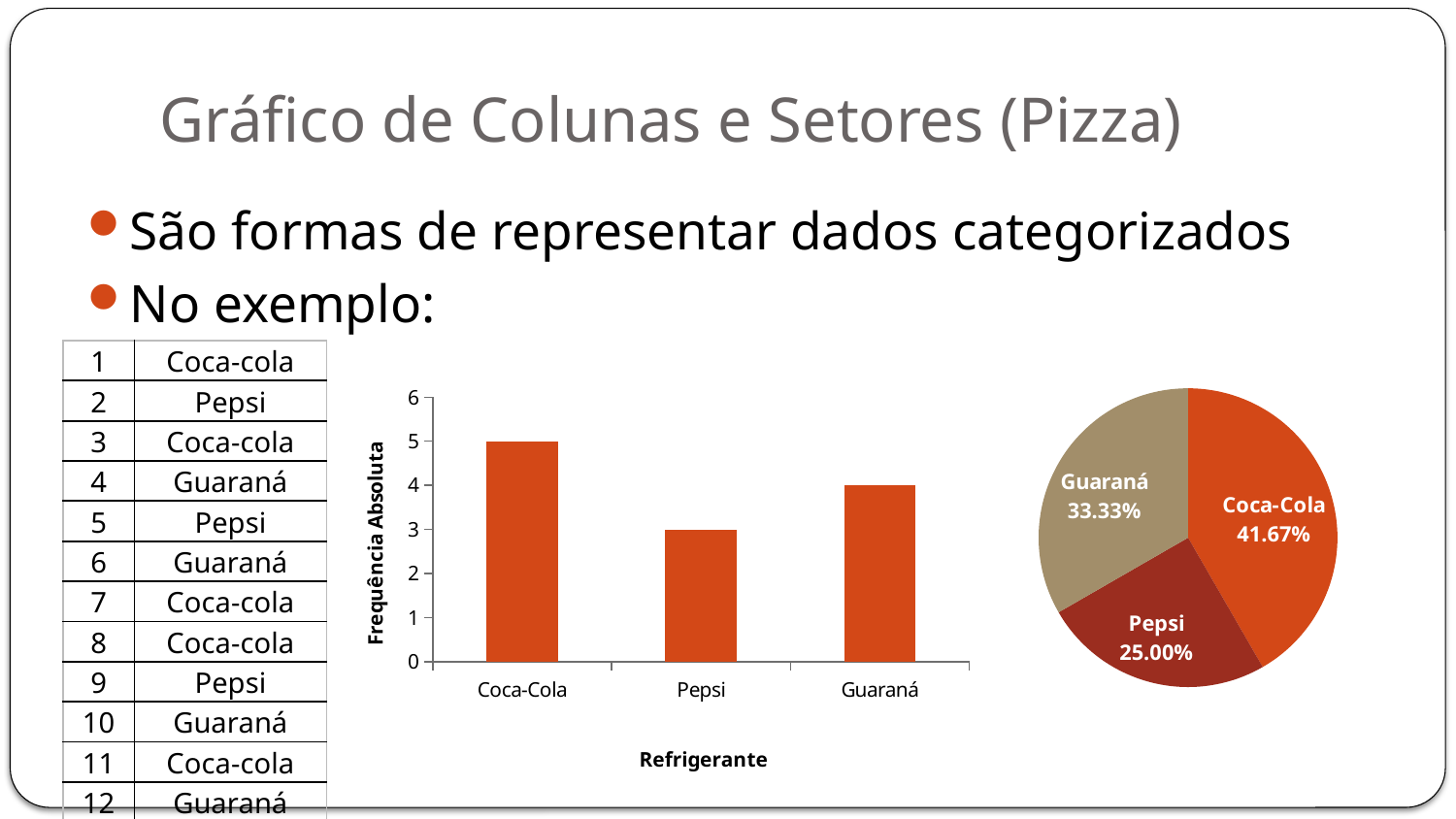
In the bar chart, which refrigerante has the highest Frequência Absoluta? Coca-Cola In the bar chart, what is the Frequência Absoluta for Coca-Cola? 5 In the bar chart, what is the Frequência Absoluta for Pepsi? 3 In the pie chart, what share does Pepsi have? 25.00% In the bar chart, which is larger, the value for Guaraná or the value for Pepsi? Guaraná What kind of chart is the chart on the left with the axis title Refrigerante? Bar chart How many categories are shown on the x axis of the bar chart? 3 In the pie chart, what share does Coca-Cola have? 41.67% In the bar chart, what is the difference between the Frequência Absoluta of Coca-Cola and Pepsi? 2 In the bar chart, which refrigerante has the lowest Frequência Absoluta? Pepsi In the bar chart, what is the Frequência Absoluta for Guaraná? 4 In the pie chart, which slice is the largest? Coca-Cola